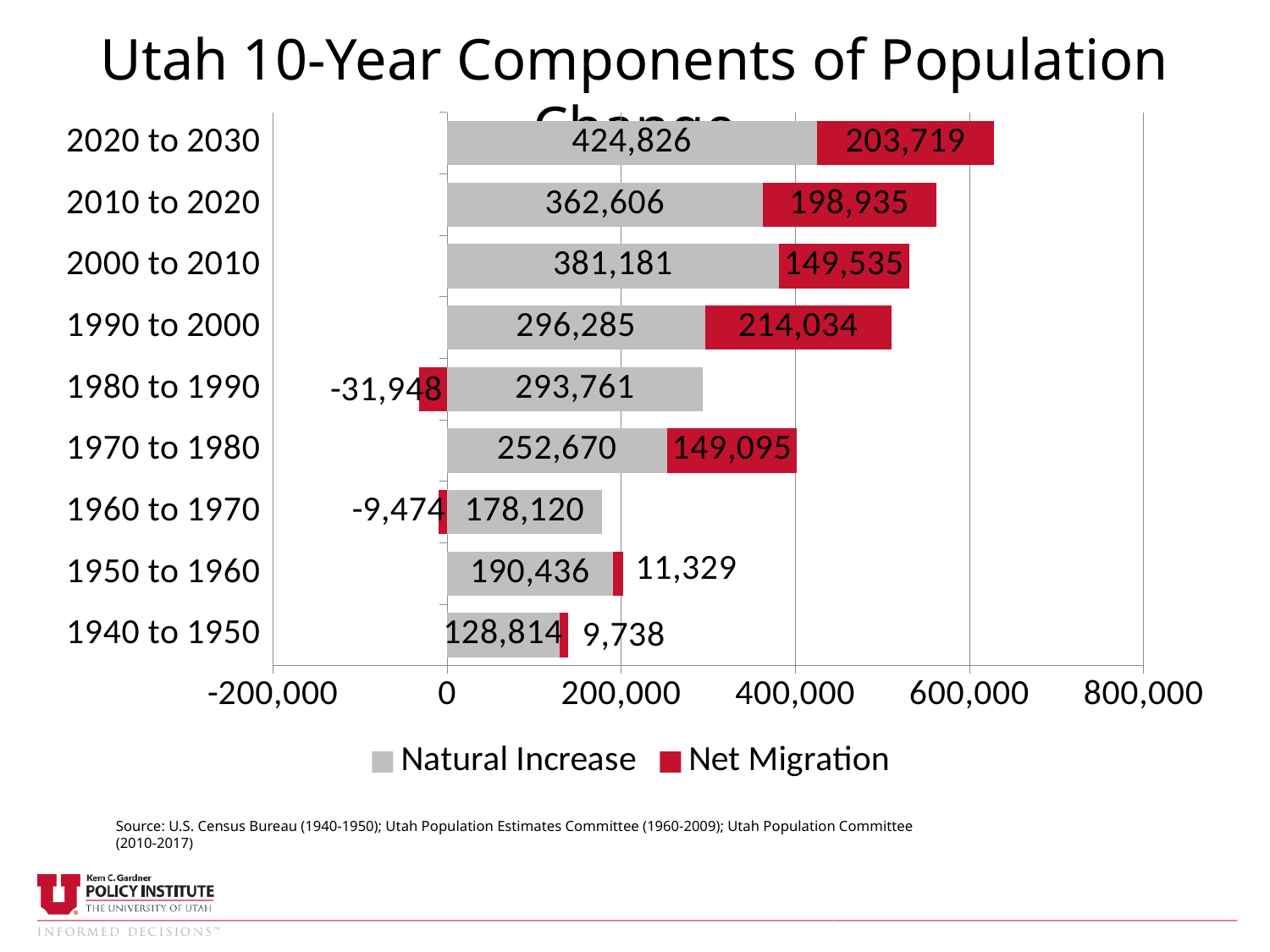
How many decades are shown on the chart? 9 What is the total of Natural Increase and Net Migration for 2020 to 2030? 628,545 Which has the larger Natural Increase, 2000 to 2010 or 2010 to 2020? 2000 to 2010 How many series does the legend list? 2 How many decades show a negative Net Migration? 2 What is the Net Migration value for 1990 to 2000? 214,034 What is the Natural Increase value for 2000 to 2010? 381,181 What is the Net Migration value for 1980 to 1990? -31,948 What kind of chart is shown on the slide? Stacked bar chart What is the difference between the Natural Increase for 2020 to 2030 and for 2010 to 2020? 62,220 Which decade has the lowest Natural Increase? 1940 to 1950 Which decade has the highest Net Migration? 1990 to 2000